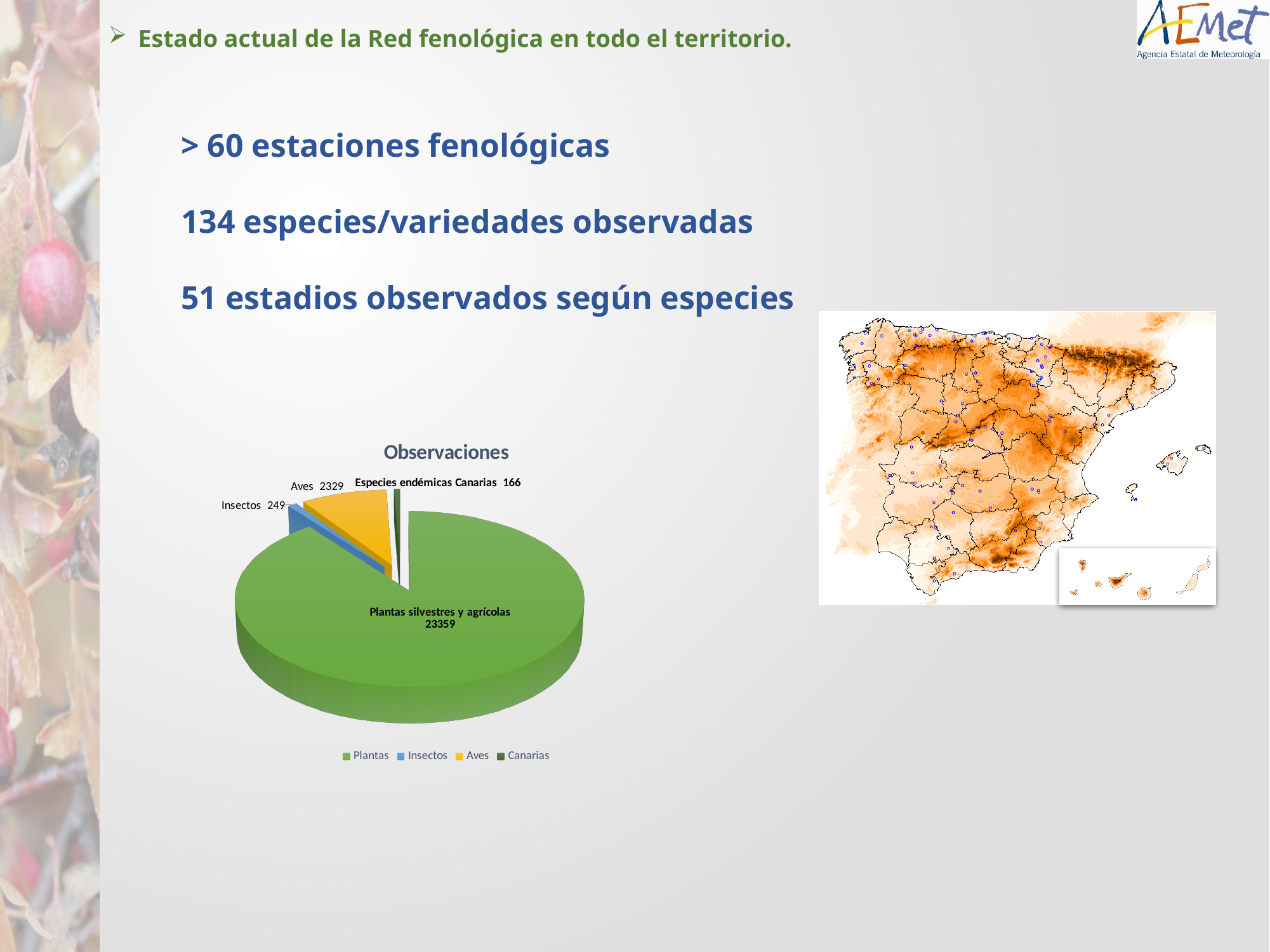
What colour is the Aves slice in the "Observaciones" pie chart? Yellow What type of chart is shown under the title "Observaciones"? Pie chart In the "Observaciones" pie chart, what is the value for Especies endémicas Canarias? 166 Which category has the smallest slice in the "Observaciones" pie chart? Especies endémicas Canarias Which category has the largest slice in the "Observaciones" pie chart? Plantas silvestres y agrícolas How many slices does the "Observaciones" pie chart have? 4 In the "Observaciones" pie chart, what is the difference between the values for Aves and Insectos? 2080 In the "Observaciones" pie chart, what is the value for Insectos? 249 In the "Observaciones" pie chart, what is the value for Aves? 2329 How many entries does the legend of the "Observaciones" pie chart list? 4 In the "Observaciones" pie chart, which is larger, the value for Insectos or the value for Especies endémicas Canarias? Insectos In the "Observaciones" pie chart, what is the value for Plantas silvestres y agrícolas? 23359